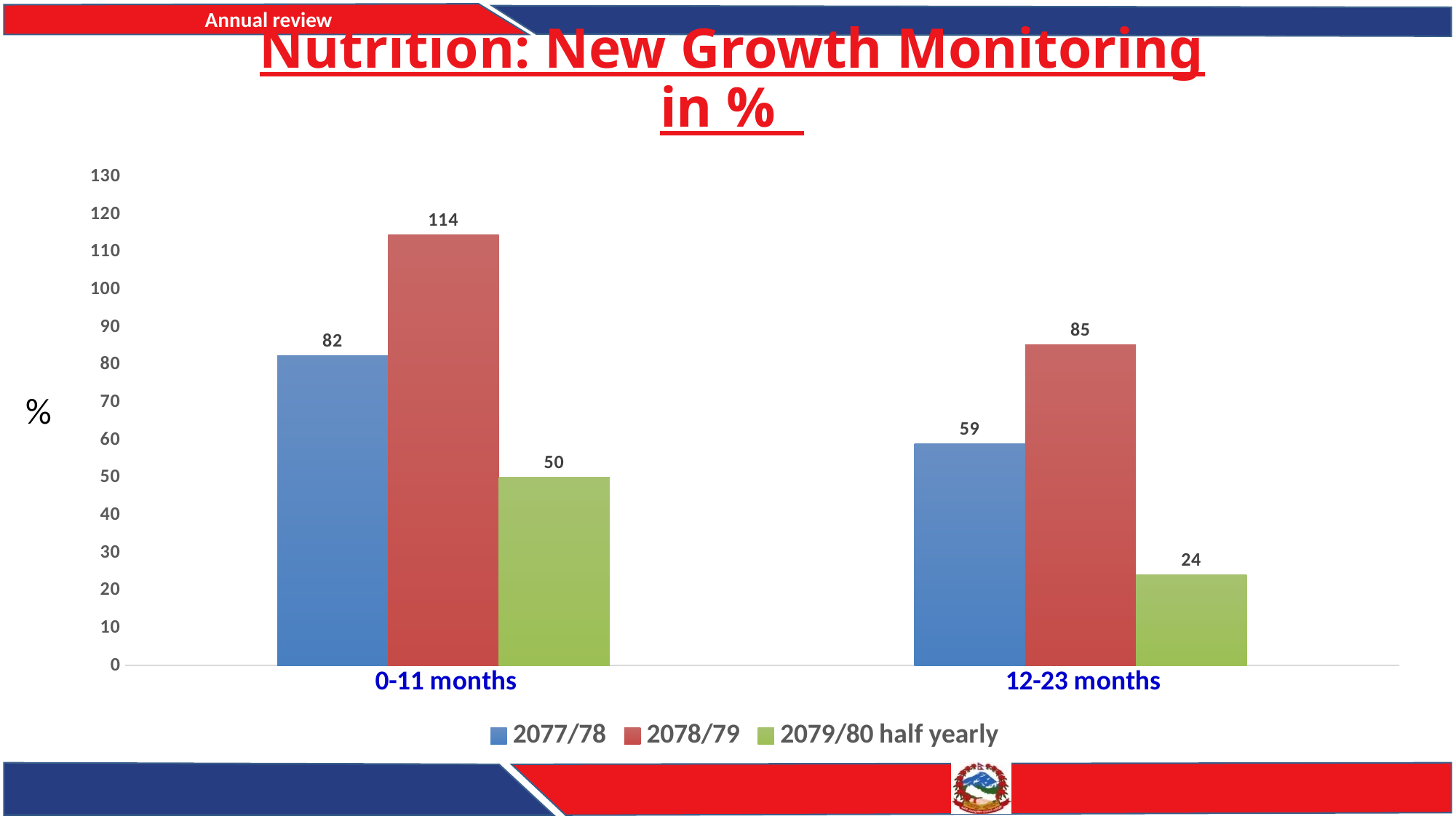
Is the value for 2079/80 half yearly in the 0-11 months category greater or less than 60? less Which series has the lowest value in the 12-23 months category? 2079/80 half yearly What is the difference between the 2078/79 values for 0-11 months and 12-23 months? 29 What is the value for 2077/78 in the 12-23 months category? 59 Which series has the highest value in the 0-11 months category? 2078/79 What is the value for 2078/79 in the 0-11 months category? 114 What is the value for 2079/80 half yearly in the 12-23 months category? 24 How many categories are shown on the x axis? 2 What kind of chart is shown on the slide? Bar chart What is the difference between the 2077/78 and 2079/80 half yearly values in the 0-11 months category? 32 How many series does the legend list? 3 Which is larger: the 2077/78 value for 0-11 months or the 2078/79 value for 12-23 months? 2078/79 value for 12-23 months